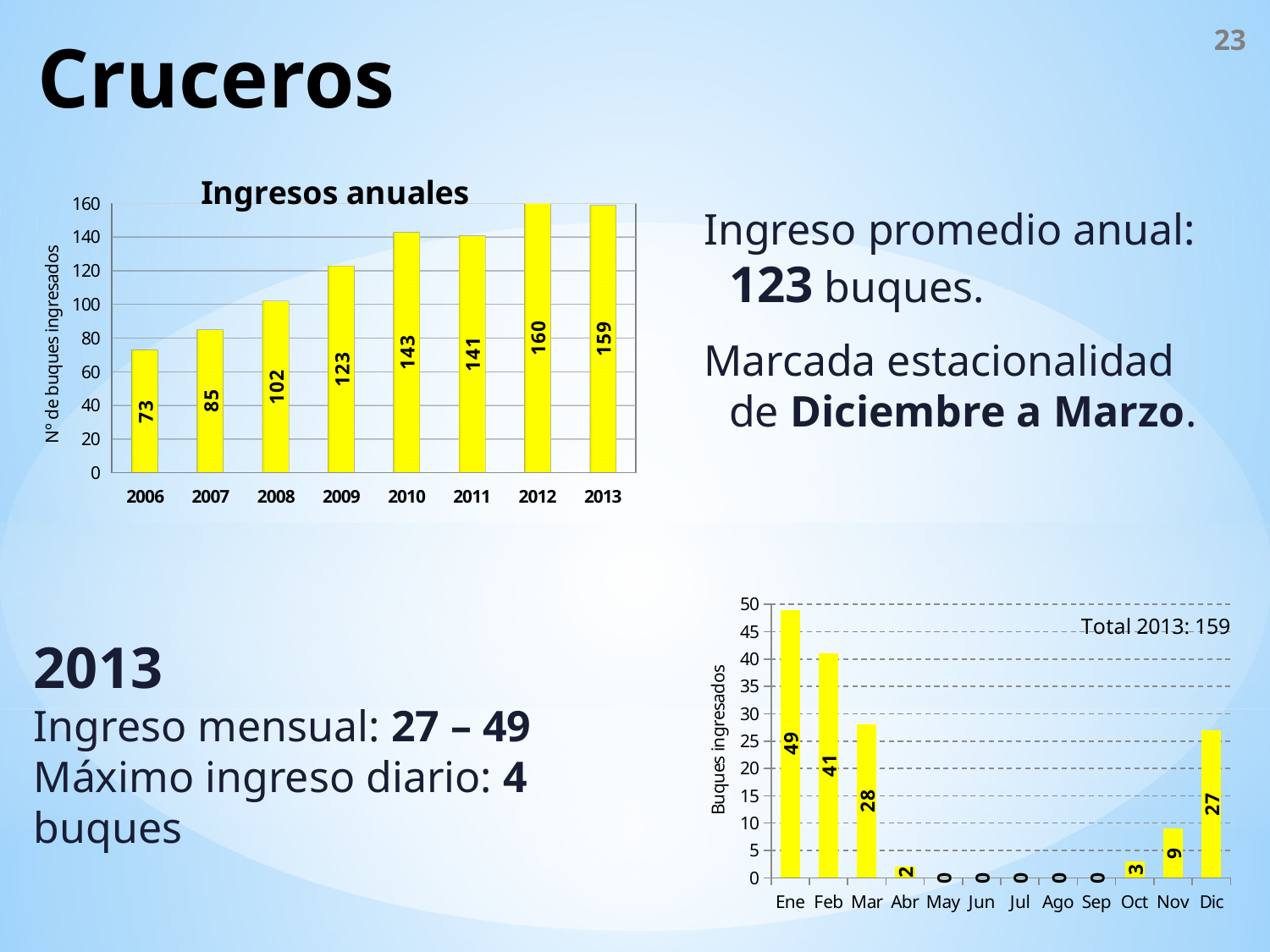
In the 'Ingresos anuales' chart, which is larger, the value for 2010 or the value for 2011? 2010 In the 'Ingresos anuales' chart, what is the value for 2009? 123 In the monthly chart at the bottom right, what is the value for Feb? 41 In the 'Ingresos anuales' chart, which year has the lowest value? 2006 In the 'Ingresos anuales' chart, what is the y-axis label? Nº de buques ingresados In the 'Ingresos anuales' chart, which year has the highest value? 2012 In the 'Ingresos anuales' chart, what is the difference between the values for 2013 and 2006? 86 What kind of chart is the 'Ingresos anuales' chart? Bar chart In the monthly chart at the bottom right, what is the difference between the values for Mar and Dic? 1 In the monthly chart at the bottom right, how many months have a value of 0? 5 In the 'Ingresos anuales' chart, how many years are shown on the x axis? 8 In the monthly chart at the bottom right, which month has the highest value? Ene